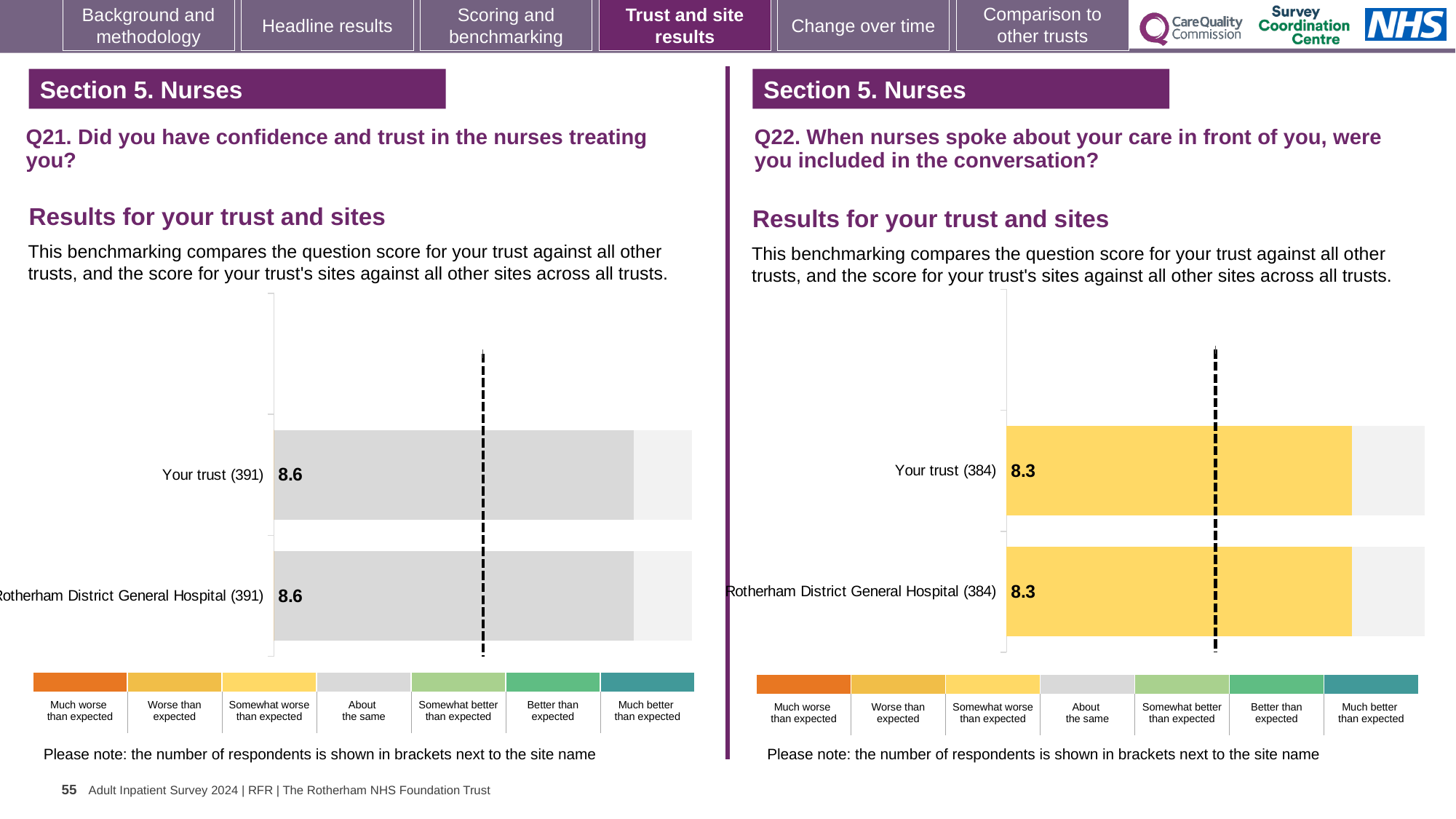
In the Q21 chart on the left, what is the score for Your trust? 8.6 In the Q21 chart on the left, what is the difference between the score for Your trust and the score for Rotherham District General Hospital? 0 In the Q21 chart on the left, what is the score for Rotherham District General Hospital? 8.6 In the Q22 chart on the right, what is the score for Rotherham District General Hospital? 8.3 In the Q22 chart on the right, how many respondents are shown in brackets next to Rotherham District General Hospital? 384 In the Q21 chart on the left, how many respondents are shown in brackets next to Your trust? 391 How many bars are plotted in the Q22 chart on the right? 2 In the Q22 chart on the right, what is the difference between the score for Your trust and the score for Rotherham District General Hospital? 0 What kind of chart is used for the Q21 results on the left? Bar chart How many bars are plotted in the Q21 chart on the left? 2 According to the colour key, which benchmark category do the yellow bars in the Q22 chart on the right represent? Somewhat worse than expected In the Q22 chart on the right, what is the score for Your trust? 8.3